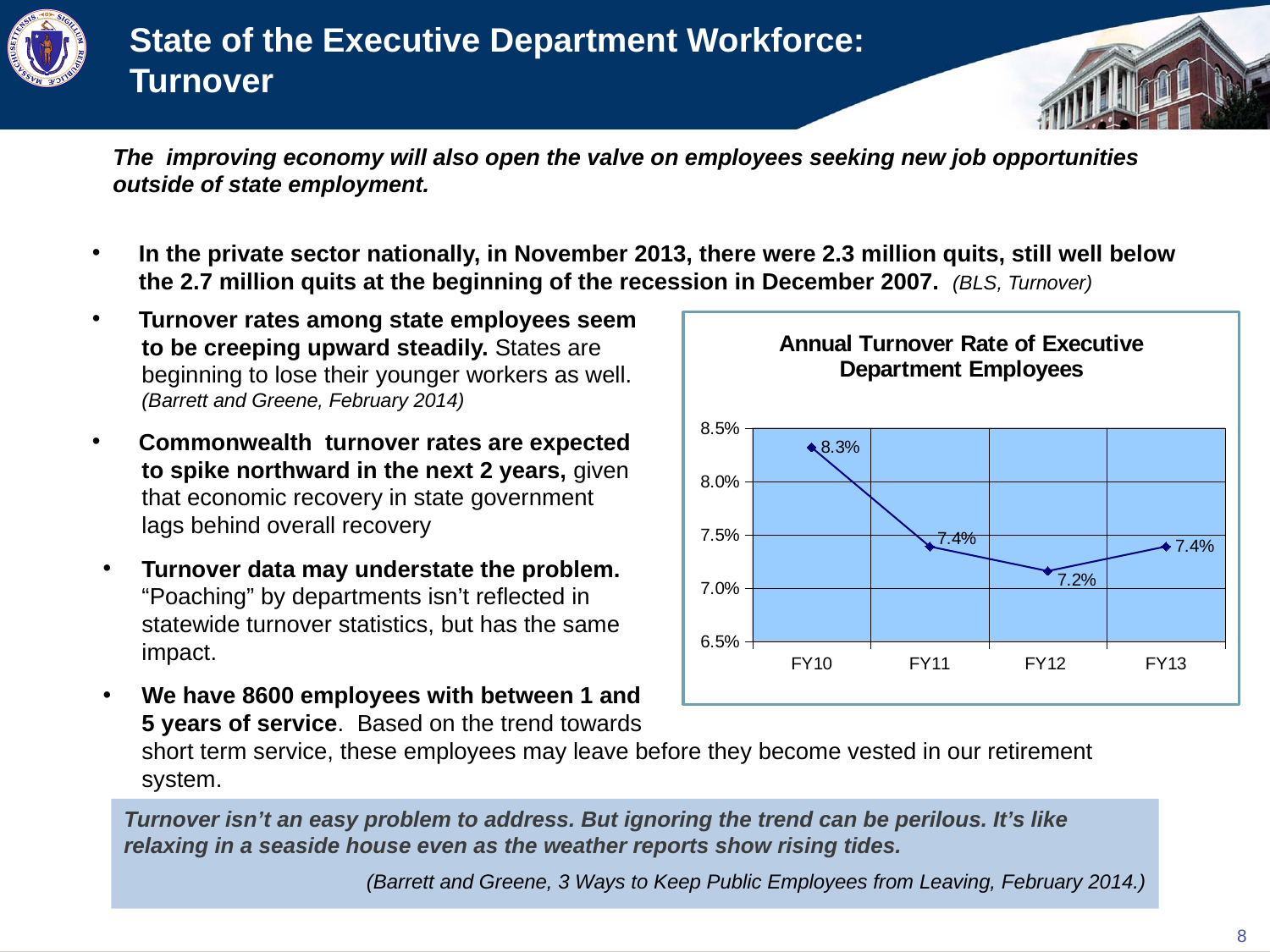
How many fiscal years are plotted on the chart? 4 What is the difference between the turnover rate in FY10 and FY11? 0.9% What kind of chart is shown on the slide? line chart Which fiscal year has the highest turnover rate? FY10 What is the annual turnover rate for FY13? 7.4% What is the annual turnover rate for FY10? 8.3% Is the turnover rate for FY10 greater or less than 8.0%? greater Which fiscal year has the lowest turnover rate? FY12 Which is larger, the turnover rate in FY10 or FY12? FY10 What is the difference between the turnover rate in FY13 and FY12? 0.2% What is the title of the chart? Annual Turnover Rate of Executive Department Employees What is the annual turnover rate for FY12? 7.2%